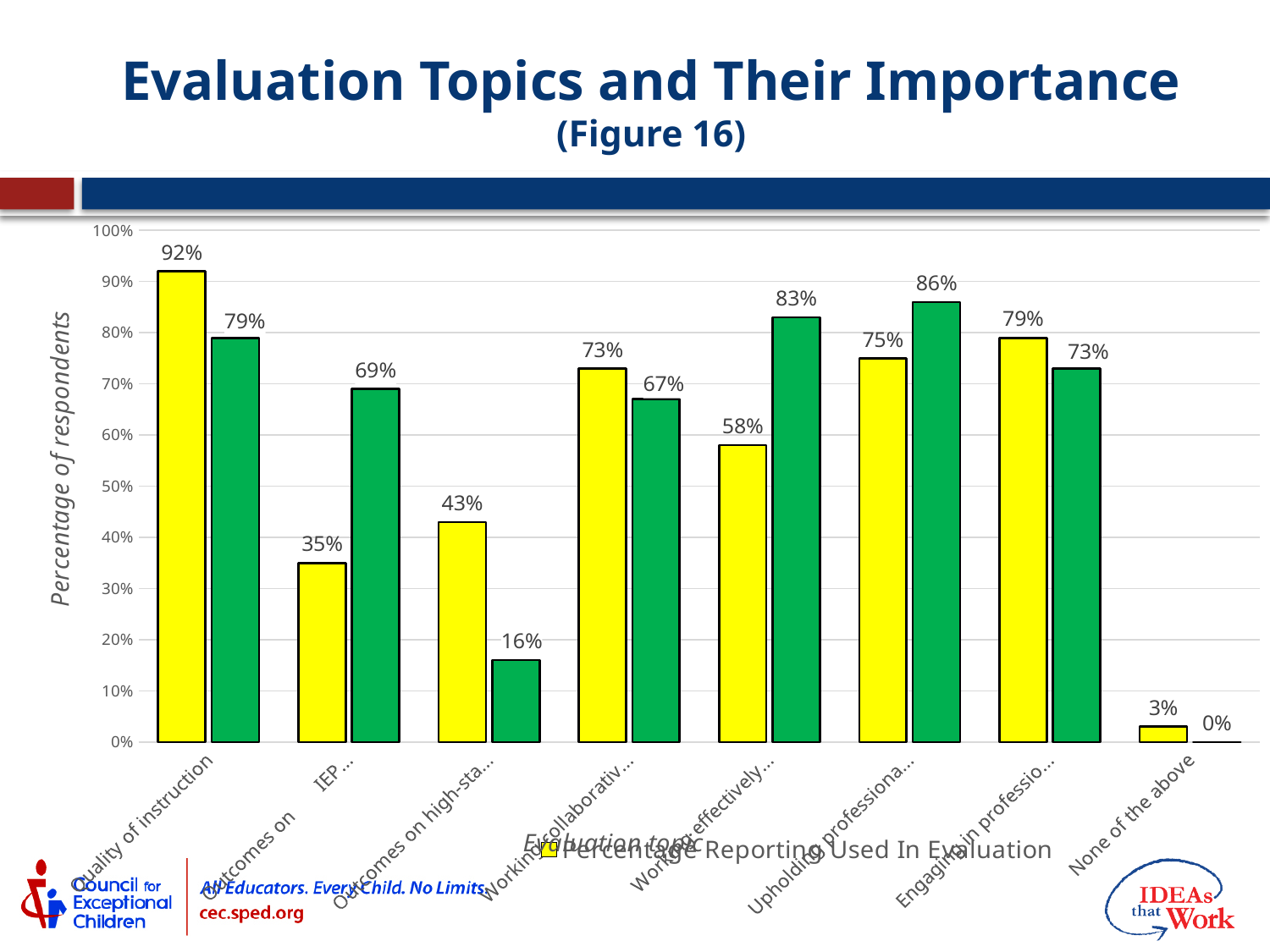
What is the value of the yellow bar (Percentage Reporting Used In Evaluation) for Quality of instruction? 92% What type of chart is shown on the slide? bar chart What is the difference between the yellow and green bars for Quality of instruction? 13 percentage points What is the value of the green bar for None of the above? 0% Is the value of the green bar for Quality of instruction greater or less than 70%? greater How many evaluation topic categories are shown on the x axis? 8 For the Quality of instruction category, which bar is larger, the yellow or the green? yellow What is the title of the chart? Evaluation Topics and Their Importance (Figure 16) Which category has the lowest green bar? None of the above Which category has the highest yellow bar (Percentage Reporting Used In Evaluation)? Quality of instruction What is the value of the yellow bar (Percentage Reporting Used In Evaluation) for None of the above? 3% What is the label on the y axis? Percentage of respondents